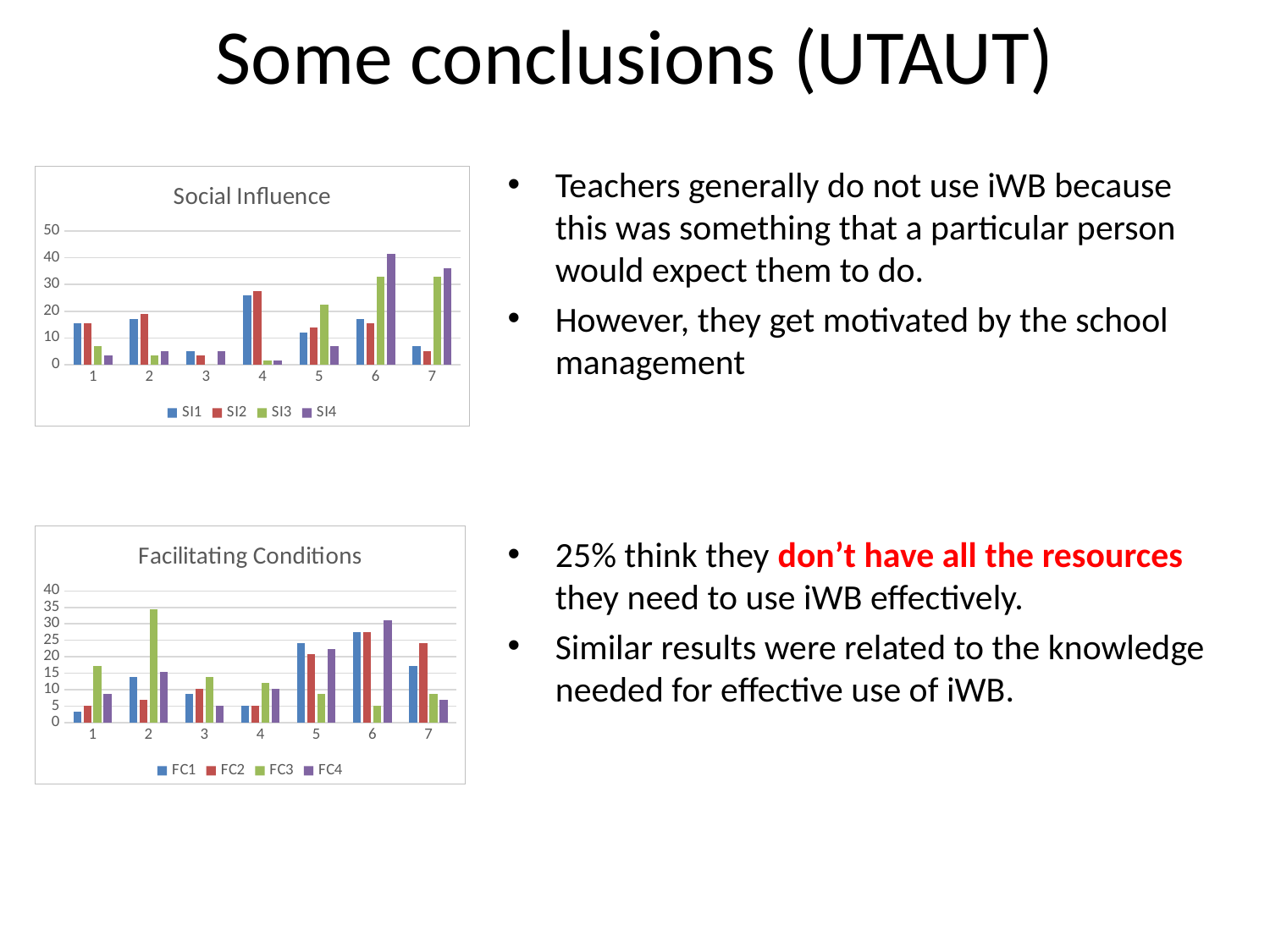
In the Social Influence chart, at category 5, which is larger: SI1 or SI3? SI3 In the Facilitating Conditions chart, is the value for FC3 at category 2 greater or less than 30? greater In the Social Influence chart, which series has the highest bar at category 6? SI4 In the Facilitating Conditions chart, what are the legend entries? FC1, FC2, FC3, FC4 In the Facilitating Conditions chart, how many series does the legend list? 4 In the Social Influence chart, how many series does the legend list? 4 In the Social Influence chart, how many categories are shown on the x axis? 7 In the Social Influence chart, is the value for SI4 at category 6 greater or less than 30? greater In the Facilitating Conditions chart, which category has the highest FC3 value? 2 In the Social Influence chart, is the value for SI3 at category 3 greater or less than 10? less In the Social Influence chart, what kind of chart is shown? bar chart In the Facilitating Conditions chart, what kind of chart is shown? bar chart